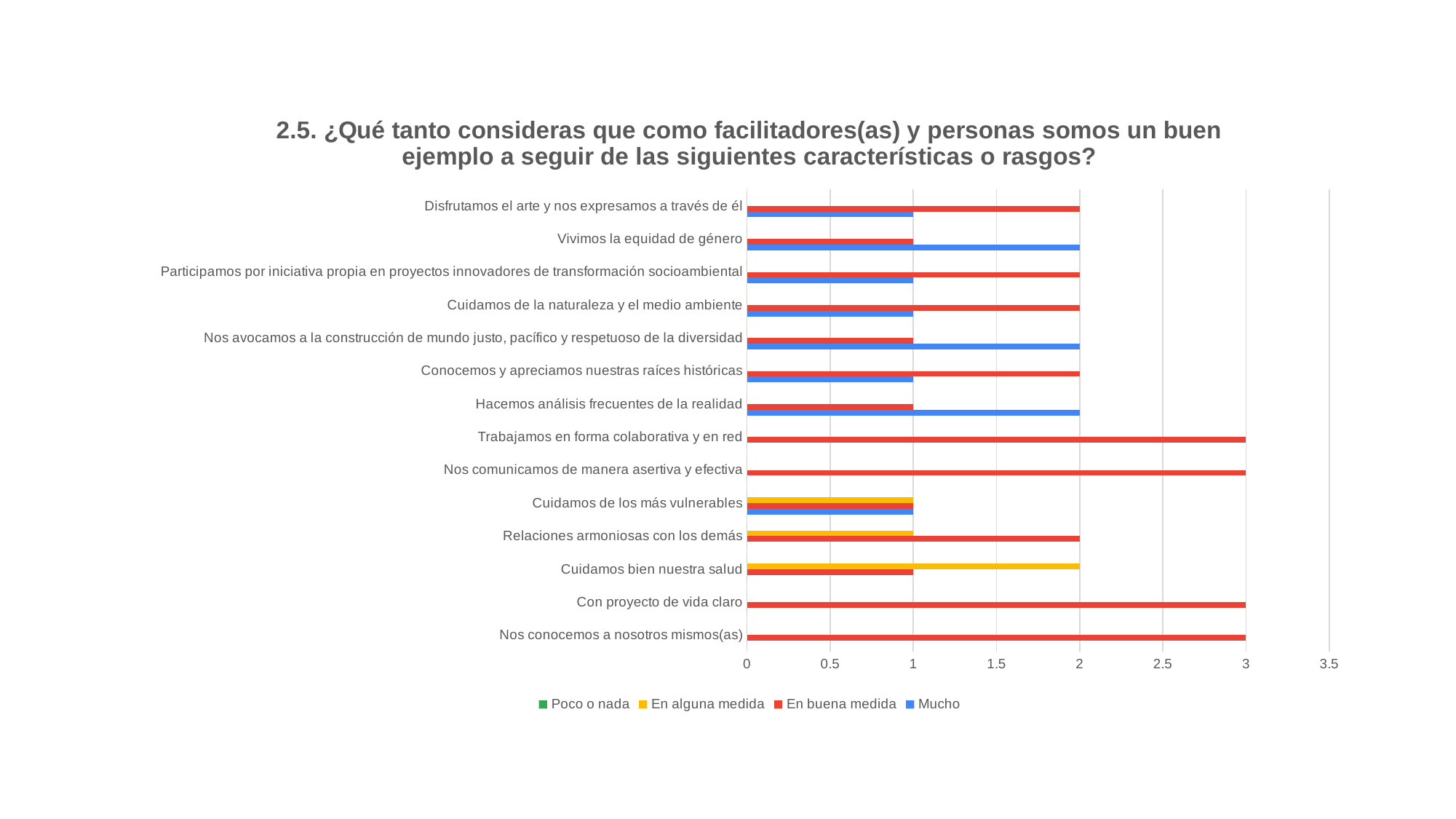
Is the value of "En buena medida" for "Con proyecto de vida claro" greater or less than 2.5? greater What is the value of "Mucho" for "Vivimos la equidad de género"? 2 What is the value of "En buena medida" for "Trabajamos en forma colaborativa y en red"? 3 How many series does the legend list? 4 What is the value of "En alguna medida" for "Cuidamos bien nuestra salud"? 2 Which is larger for "Hacemos análisis frecuentes de la realidad": "En buena medida" or "Mucho"? Mucho How many categories are plotted on the chart? 14 Which legend entry is shown in yellow? En alguna medida What kind of chart is shown on the slide? bar chart What is the difference between "En buena medida" and "Mucho" for "Disfrutamos el arte y nos expresamos a través de él"? 1 What is the value of "En buena medida" for "Cuidamos de la naturaleza y el medio ambiente"? 2